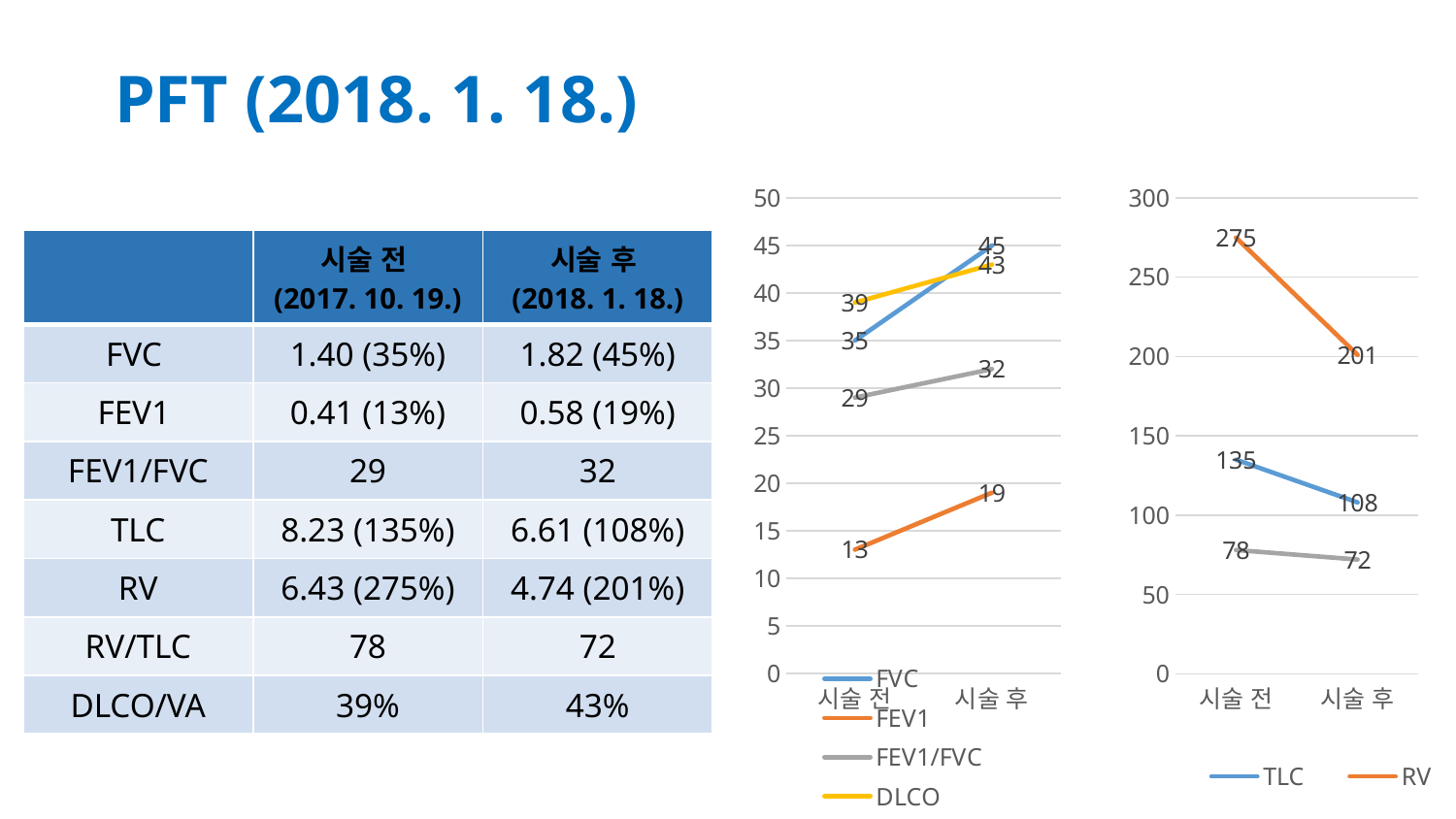
In the left chart, what is the FVC value at 시술 후? 45 In the left chart, does the FEV1/FVC line rise or fall from 시술 전 to 시술 후? rises In the left chart, which series has the lowest value at 시술 전? FEV1 In the right chart, what is the RV value at 시술 후? 201 In the left chart, what is the DLCO value at 시술 후? 43 What kind of chart is the left chart (with FVC, FEV1, FEV1/FVC and DLCO)? line chart How many series does the legend of the left chart list? 4 How many series does the legend of the right chart list? 2 In the left chart, what is the FEV1 value at 시술 전? 13 In the right chart, which is larger at 시술 전, RV or TLC? RV In the right chart, what is the difference between the TLC values at 시술 전 and 시술 후? 27 In the left chart, by how much does FVC increase from 시술 전 to 시술 후? 10